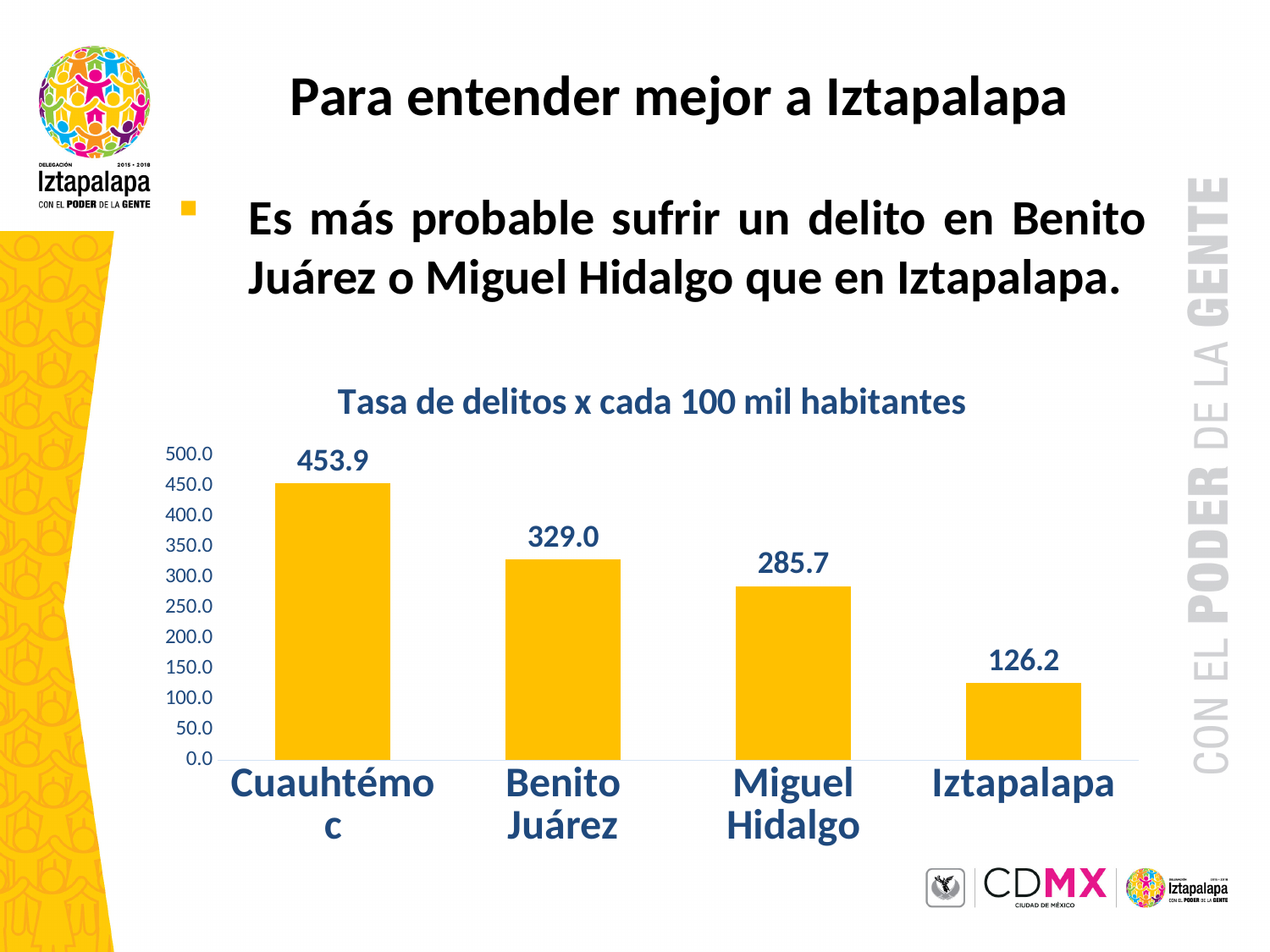
Which is larger, the value for Benito Juárez or the value for Miguel Hidalgo? Benito Juárez What kind of chart is shown on the slide? Bar chart Which delegación has the lowest crime rate in the chart? Iztapalapa How many delegaciones are shown in the chart? 4 What is the value shown for Miguel Hidalgo? 285.7 What is the difference between the values for Cuauhtémoc and Iztapalapa? 327.7 What is the value shown for Benito Juárez? 329.0 What is the title of the chart? Tasa de delitos x cada 100 mil habitantes What is the value shown for Iztapalapa? 126.2 What is the difference between the values for Benito Juárez and Miguel Hidalgo? 43.3 What is the crime rate per 100 thousand inhabitants for Cuauhtémoc? 453.9 Which delegación has the highest crime rate in the chart? Cuauhtémoc